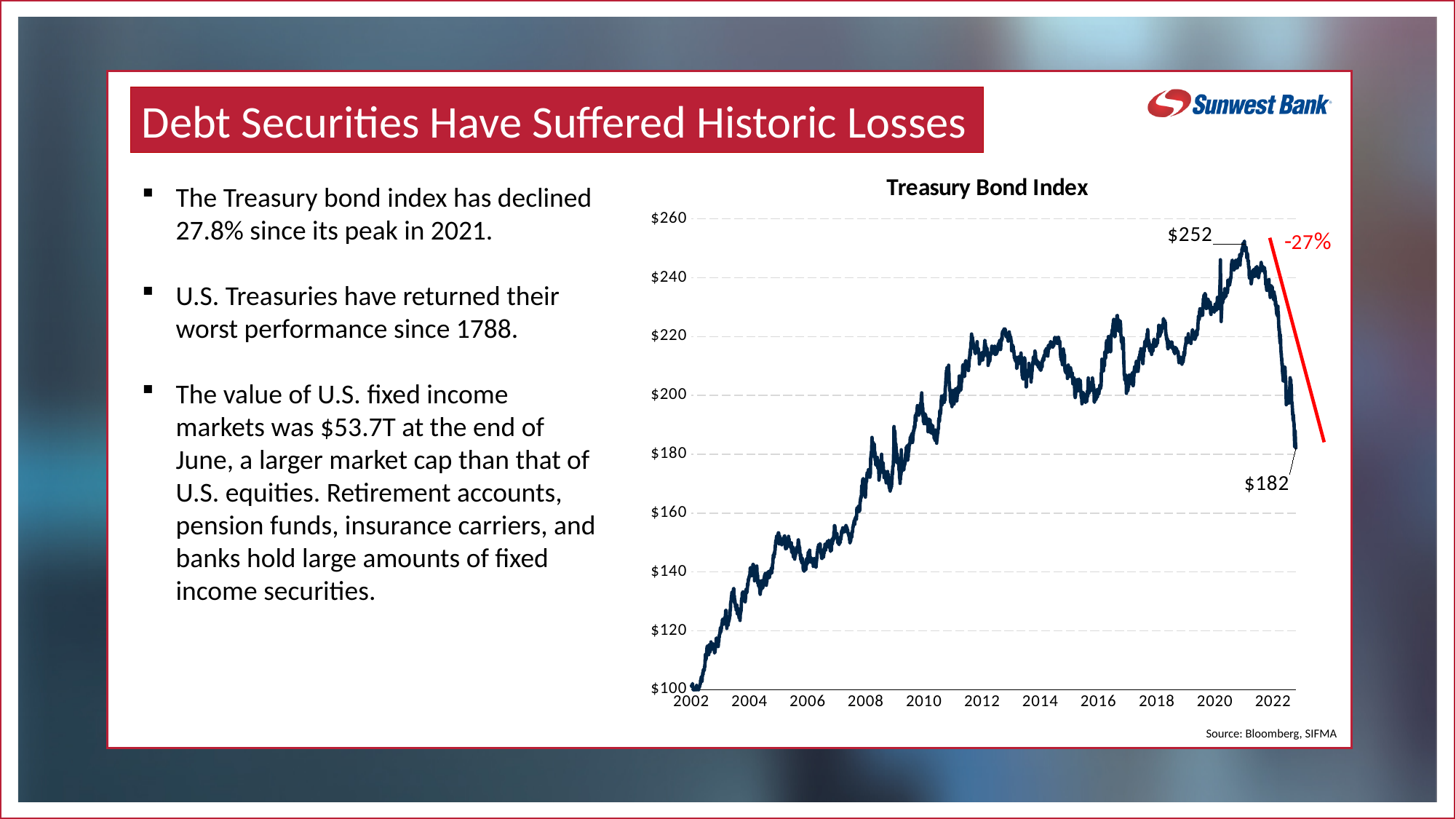
What is the peak value labelled on the Treasury Bond Index chart? $252 Is the value of the Treasury Bond Index in 2012 greater or less than $200? greater What is the difference between the labelled peak value and the labelled end value on the chart? $70 Does the Treasury Bond Index rise or fall from its 2021 peak to the end of the line in 2022? fall What is the highest value reached by the Treasury Bond Index line? $252 What type of chart is shown on the slide? line chart Is the value of the Treasury Bond Index in 2008 greater or less than $200? less What is the most recent value labelled at the end of the Treasury Bond Index line? $182 Does the Treasury Bond Index rise or fall from 2002 to its peak in 2021? rise Is the value of the Treasury Bond Index in 2004 greater or less than $160? less What is the title of the chart? Treasury Bond Index What percentage change is annotated in red next to the decline at the right of the chart? -27%